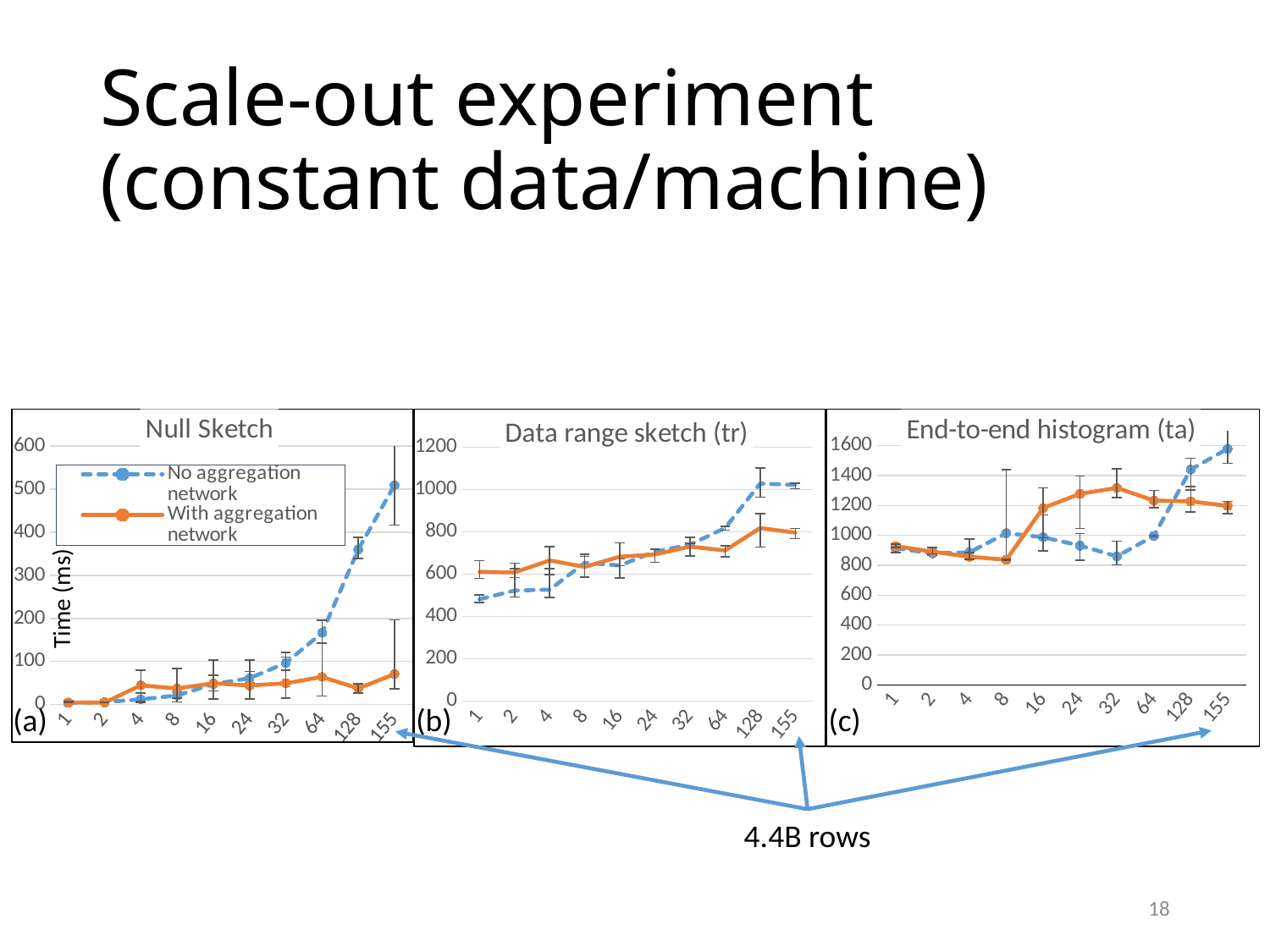
In the End-to-end histogram (ta) chart, is the value for No aggregation network at 155 greater or less than 1400? greater In the Null Sketch chart, at which x-axis category is the No aggregation network series highest? 155 What is the y-axis label of the Null Sketch chart? Time (ms) In the Data range sketch (tr) chart, which series has the larger value at 155, No aggregation network or With aggregation network? No aggregation network In the Null Sketch chart, is the value for No aggregation network at 155 greater or less than 400? greater In the Null Sketch chart, is the value for With aggregation network at 155 greater or less than 100? less How many x-axis categories are plotted in the Data range sketch (tr) chart? 10 What kind of chart is the Null Sketch chart? line chart In the Data range sketch (tr) chart, does the No aggregation network series generally rise or fall from 1 to 128? rise In the End-to-end histogram (ta) chart, which series has the larger value at 32, No aggregation network or With aggregation network? With aggregation network How many series does the legend in the Null Sketch chart list? 2